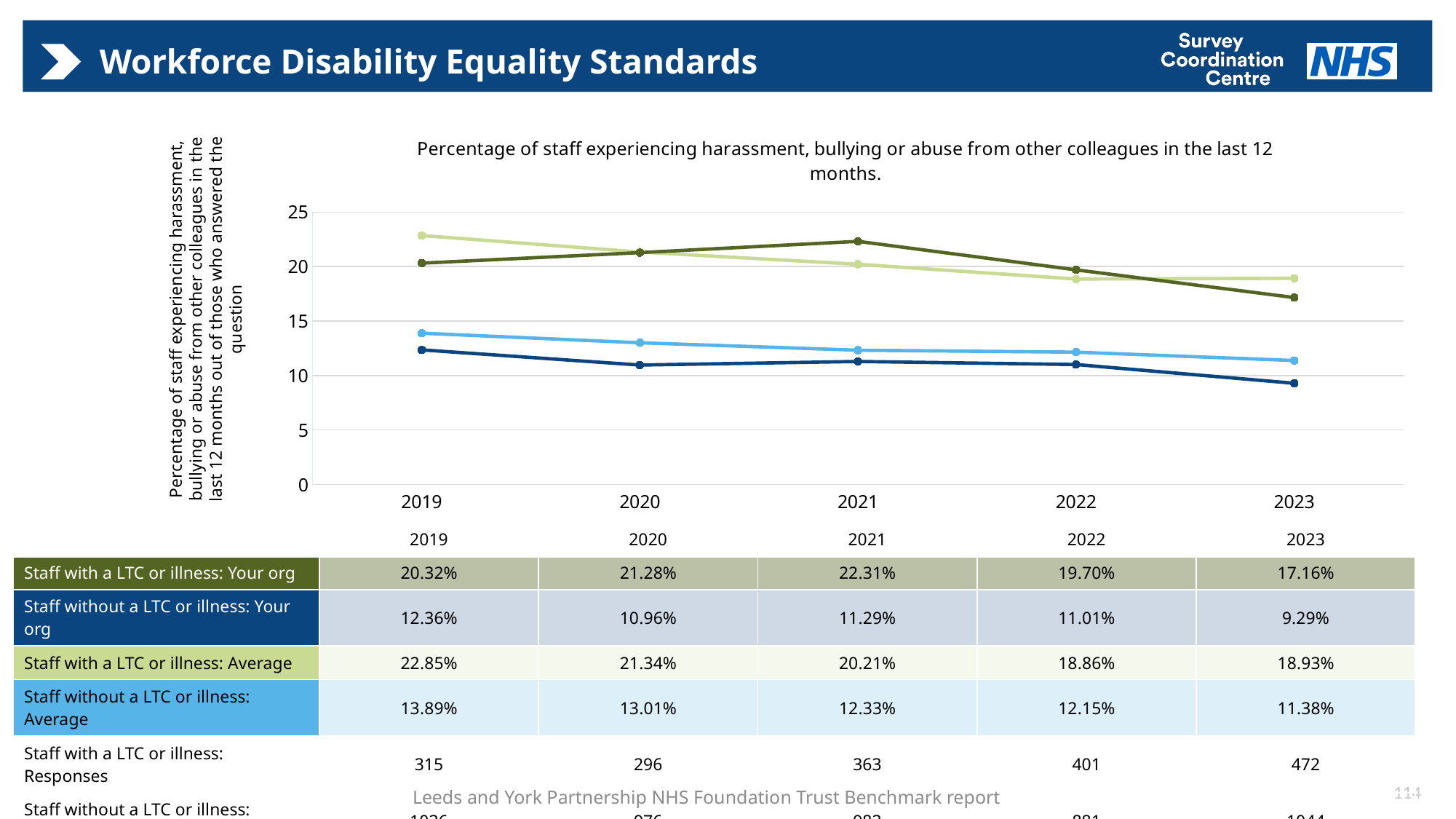
Does the value for 'Staff without a LTC or illness: Your org' rise or fall from 2019 to 2023? fall What is the difference between 'Staff with a LTC or illness: Your org' and 'Staff without a LTC or illness: Your org' in 2023? 7.87% What is the value for 'Staff without a LTC or illness: Your org' in 2023? 9.29% How many series are plotted in the chart? 4 In which year is the value for 'Staff without a LTC or illness: Average' lowest? 2023 How many years are plotted along the x axis of the chart? 5 Which is larger in 2019: 'Staff with a LTC or illness: Your org' or 'Staff with a LTC or illness: Average'? Staff with a LTC or illness: Average What type of chart is shown on the slide? line chart What is the value for 'Staff with a LTC or illness: Average' in 2019? 22.85% What is the title of the chart? Percentage of staff experiencing harassment, bullying or abuse from other colleagues in the last 12 months. What is the value for 'Staff with a LTC or illness: Your org' in 2021? 22.31% In which year is the value for 'Staff with a LTC or illness: Your org' highest? 2021